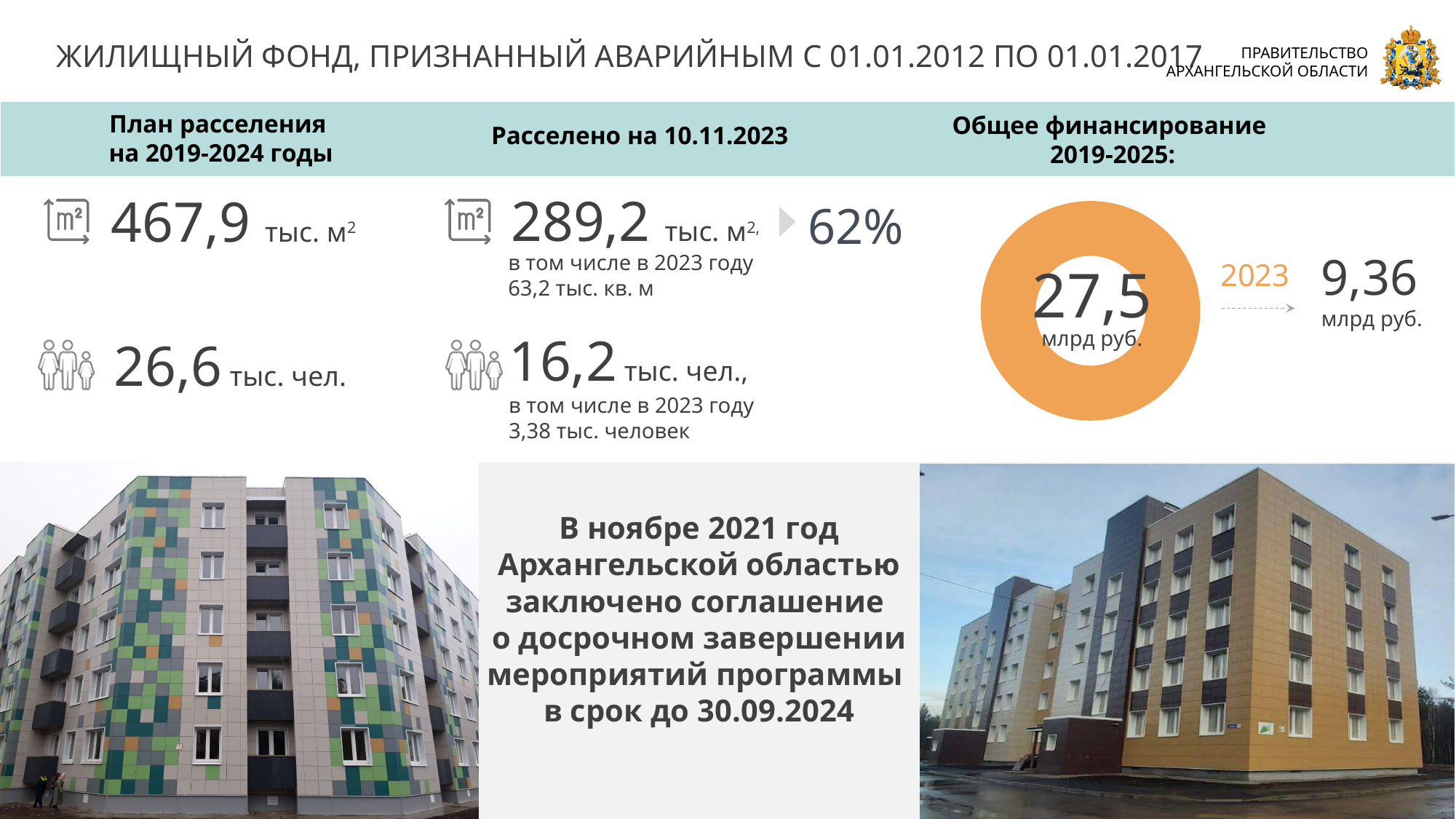
What is the heading above the orange ring chart? Общее финансирование 2019-2025: What value is shown in the centre of the orange ring chart under "Общее финансирование 2019-2025"? 27,5 млрд руб. What value is shown for 2023 to the right of the orange ring chart? 9,36 млрд руб. Which is larger: the total financing shown in the ring chart (27,5 млрд руб.) or the 2023 value (9,36 млрд руб.)? 27,5 млрд руб. What kind of chart is the orange ring under "Общее финансирование 2019-2025"? doughnut (pie) chart What colour is the ring chart on the right of the slide? orange What is the difference between the total financing in the ring chart (27,5 млрд руб.) and the 2023 value (9,36 млрд руб.)? 18,14 млрд руб. Is the value in the centre of the orange ring chart greater or less than 20 млрд руб.? greater